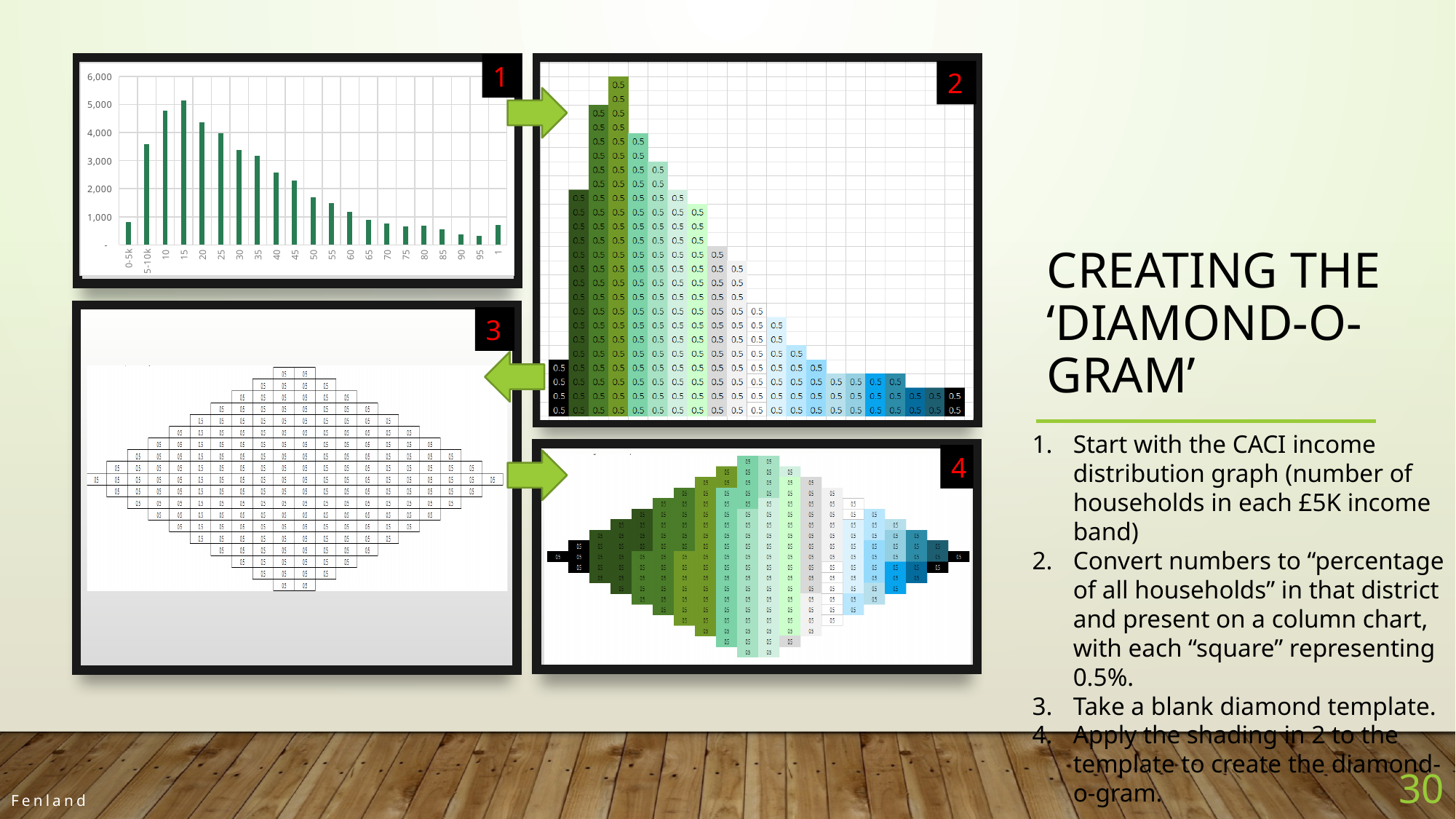
In the chart in panel 1 (top left), is the value for the 90 band greater or less than 1,000? less In the chart in panel 1 (top left), do the values generally rise or fall from the 15 band to the 95 band? fall In the chart in panel 1 (top left), how many income bands are shown on the x axis? 21 In the chart in panel 1 (top left), what is the highest value labelled on the y axis? 6,000 In the chart in panel 1 (top left), what kind of chart is shown? bar chart In the chart in panel 1 (top left), is the value for the 0-5k band greater or less than 1,000? less In the chart in panel 1 (top left), is the value for the 10 band greater or less than 4,000? greater In the chart in panel 1 (top left), which is larger, the value for the 5-10k band or the 20 band? 20 In the chart in panel 1 (top left), which income band has the tallest bar? 15 In the chart in panel 1 (top left), which is larger, the value for the 40 band or the 50 band? 40